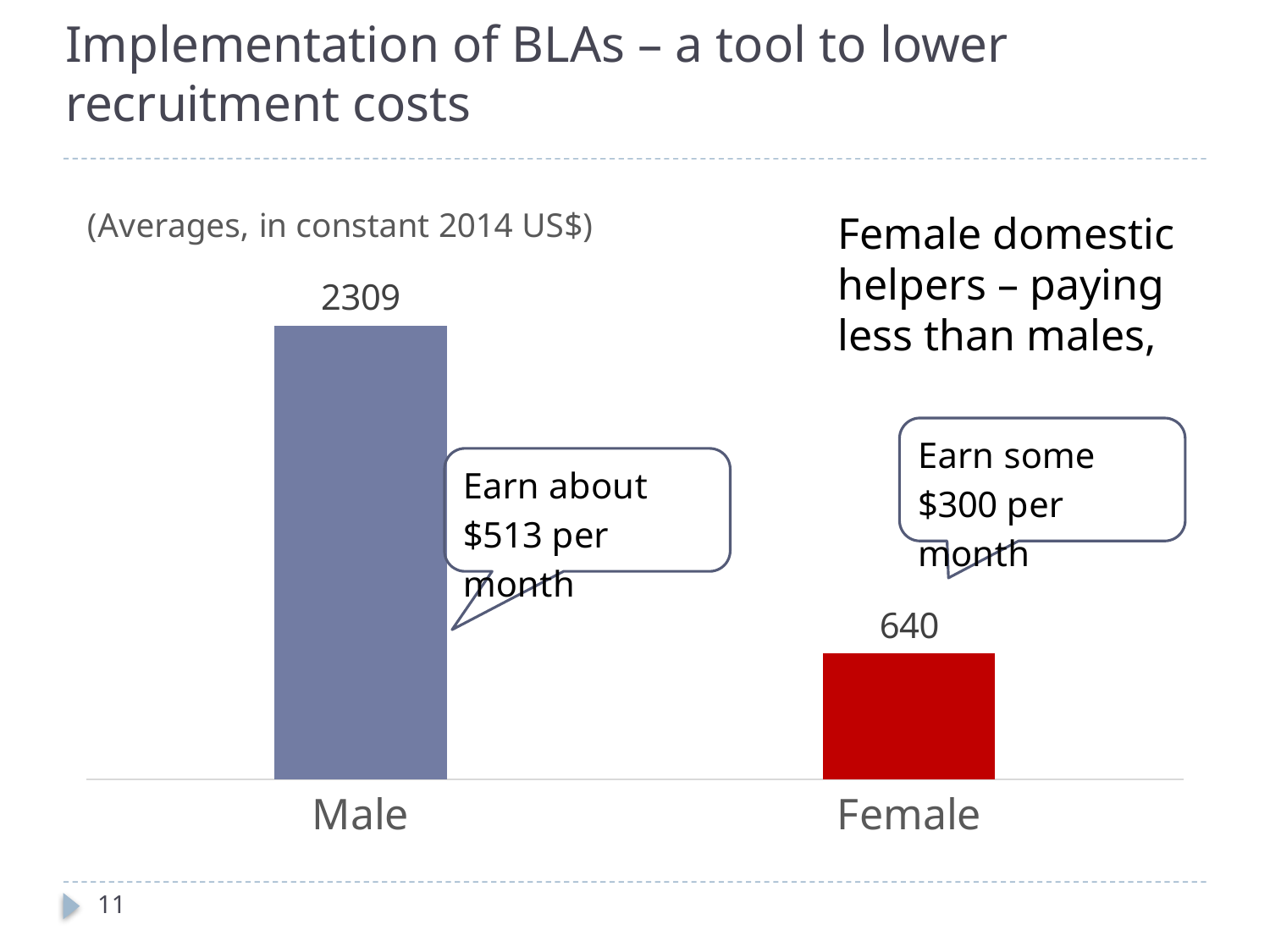
What is the value for Female? 640 Do the values rise or fall from Male to Female? fall What is the difference between the values for Male and Female? 1669 What is the value for Male? 2309 Which is larger, the value for Male or the value for Female? Male What colour is the bar for Female? red What is the subtitle text shown above the chart? (Averages, in constant 2014 US$) What kind of chart is shown on the slide? bar chart How many categories are shown in the chart? 2 Which category has the lowest value? Female Which category has the highest value? Male